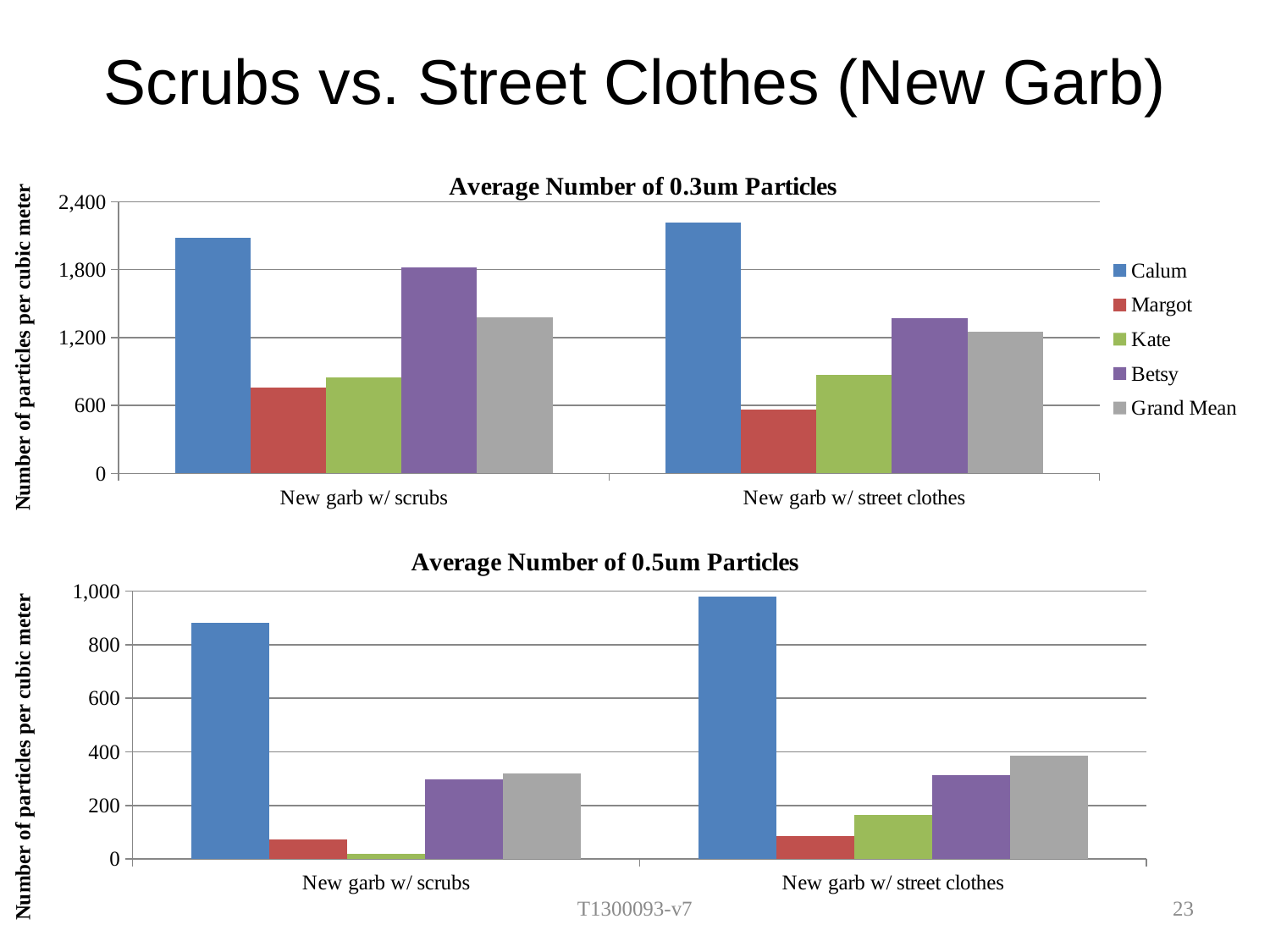
In the 'Average Number of 0.5um Particles' chart, is the Grand Mean larger for 'New garb w/ scrubs' or for 'New garb w/ street clothes'? New garb w/ street clothes In the 'Average Number of 0.5um Particles' chart, is the value for Kate under 'New garb w/ street clothes' greater or less than 200? less How many series does the legend of the 'Average Number of 0.3um Particles' chart list? 5 In the 'Average Number of 0.3um Particles' chart, is Betsy's value larger for 'New garb w/ scrubs' or for 'New garb w/ street clothes'? New garb w/ scrubs In the 'Average Number of 0.5um Particles' chart, is the value for Calum under 'New garb w/ street clothes' greater or less than 800? greater In the 'Average Number of 0.3um Particles' chart, is the value for Margot under 'New garb w/ street clothes' greater or less than 600? less How many categories are shown on the x axis of the 'Average Number of 0.5um Particles' chart? 2 In the 'Average Number of 0.3um Particles' chart, which series has the highest value for 'New garb w/ scrubs'? Calum In the 'Average Number of 0.3um Particles' chart, which series has the lowest value for 'New garb w/ street clothes'? Margot In the 'Average Number of 0.5um Particles' chart, which series has the lowest value for 'New garb w/ scrubs'? Kate What kind of chart is the 'Average Number of 0.5um Particles' chart? bar chart